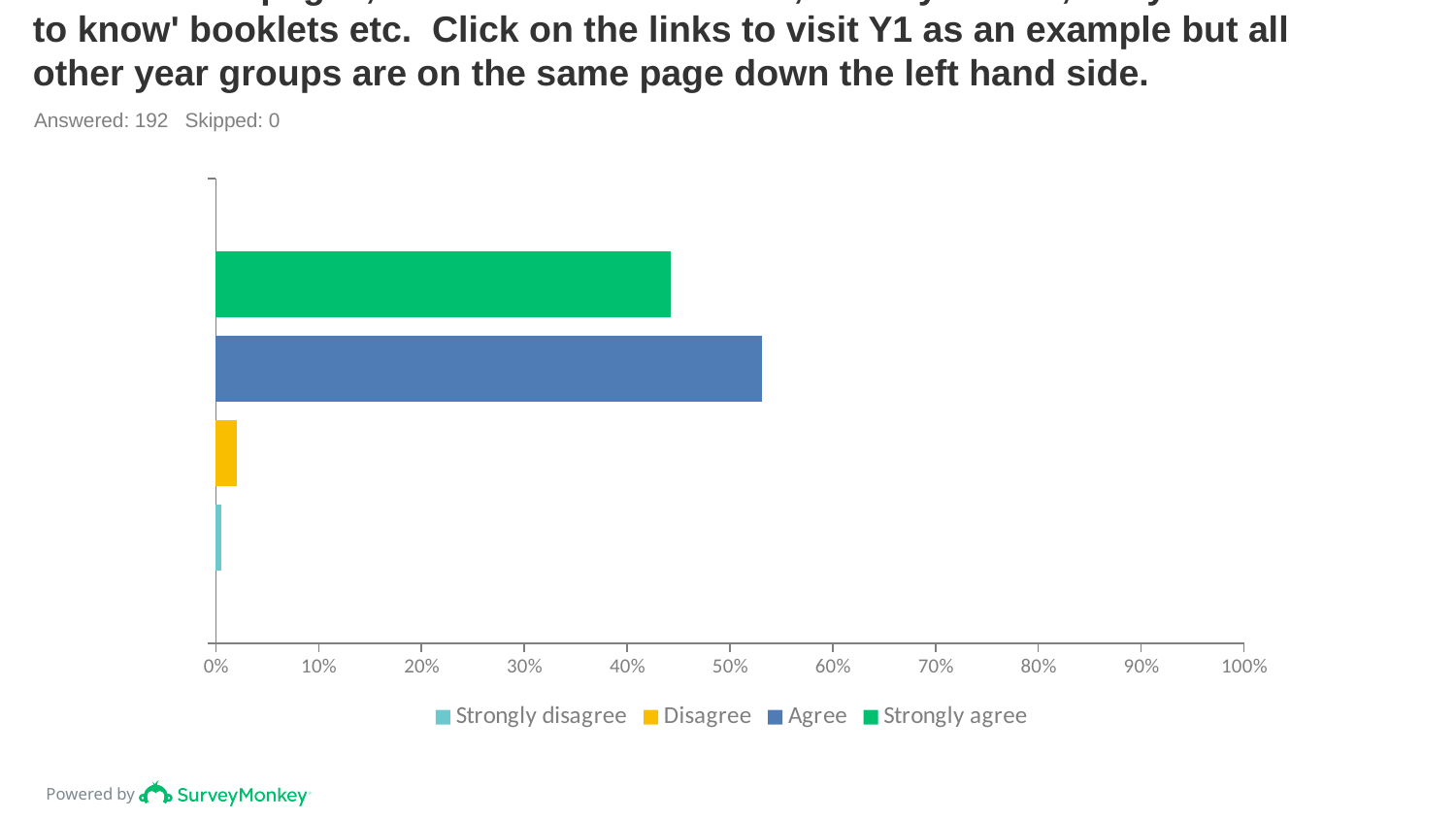
How many series does the legend list? 4 Is the value for Disagree greater or less than 10%? less Is the value for Strongly agree greater or less than 50%? less Is the value for Agree greater or less than 50%? greater What colour is the bar for Strongly agree? green Which is larger, the value for Disagree or the value for Strongly disagree? Disagree How many bars are plotted on the chart? 4 What kind of chart is shown on the slide? bar chart Which response option has the shortest bar? Strongly disagree Which response option has the longest bar? Agree Which is larger, the value for Agree or the value for Strongly agree? Agree